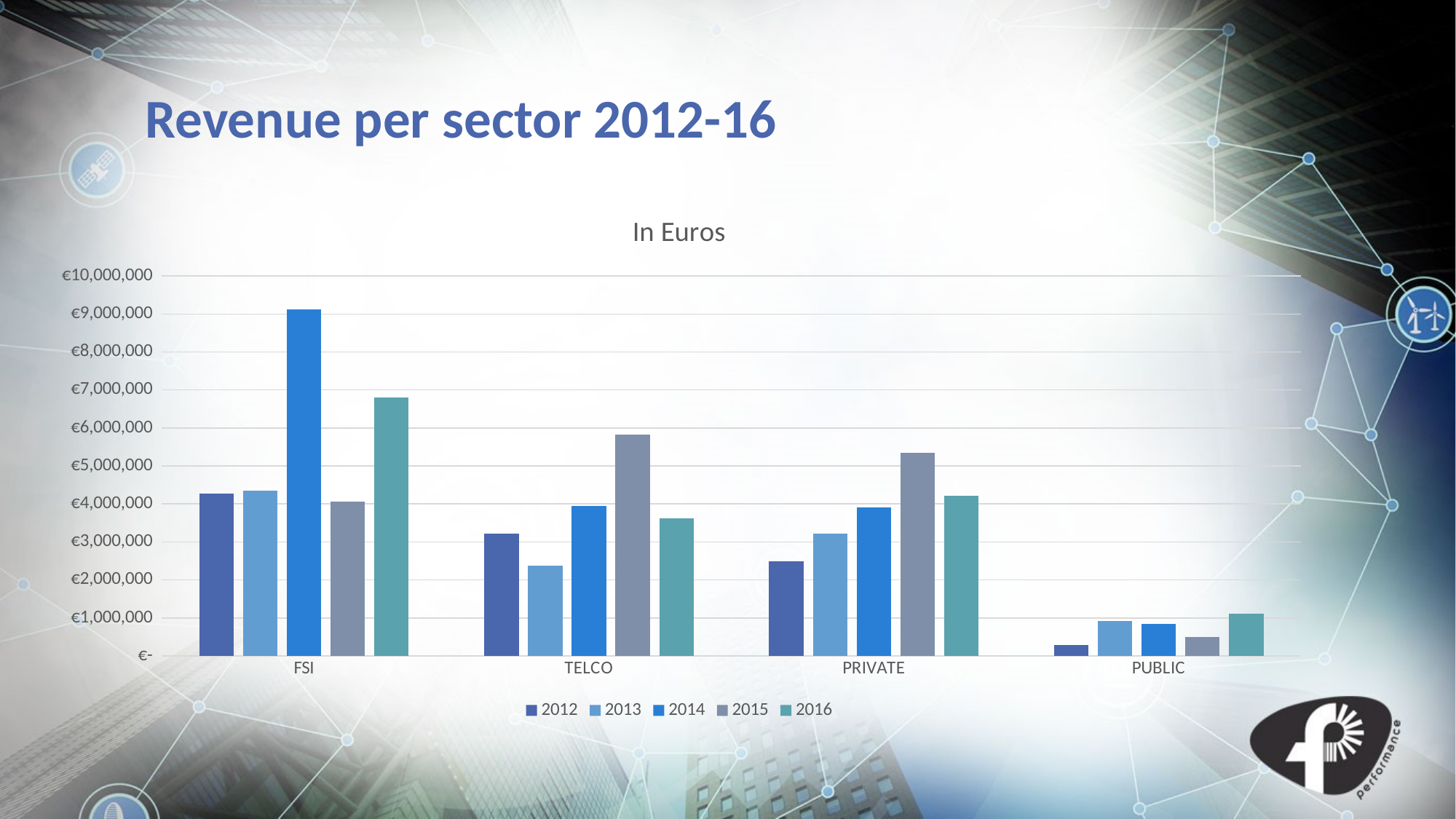
How many series does the legend list? 5 Is the 2014 revenue for FSI greater or less than €8,000,000? greater Which sector has the highest revenue for 2014? FSI Which sector has the lowest revenue for 2012? PUBLIC What kind of chart is shown on the slide? bar chart In the TELCO sector, which year has the highest revenue? 2015 Is the 2012 revenue for PUBLIC greater or less than €1,000,000? less In the PRIVATE sector, do the values rise or fall from 2012 to 2015? rise What is the title shown above the chart? In Euros Is the 2015 revenue for TELCO greater or less than €5,000,000? greater For FSI, which is larger: the 2015 revenue or the 2016 revenue? 2016 How many sectors are shown on the x axis? 4